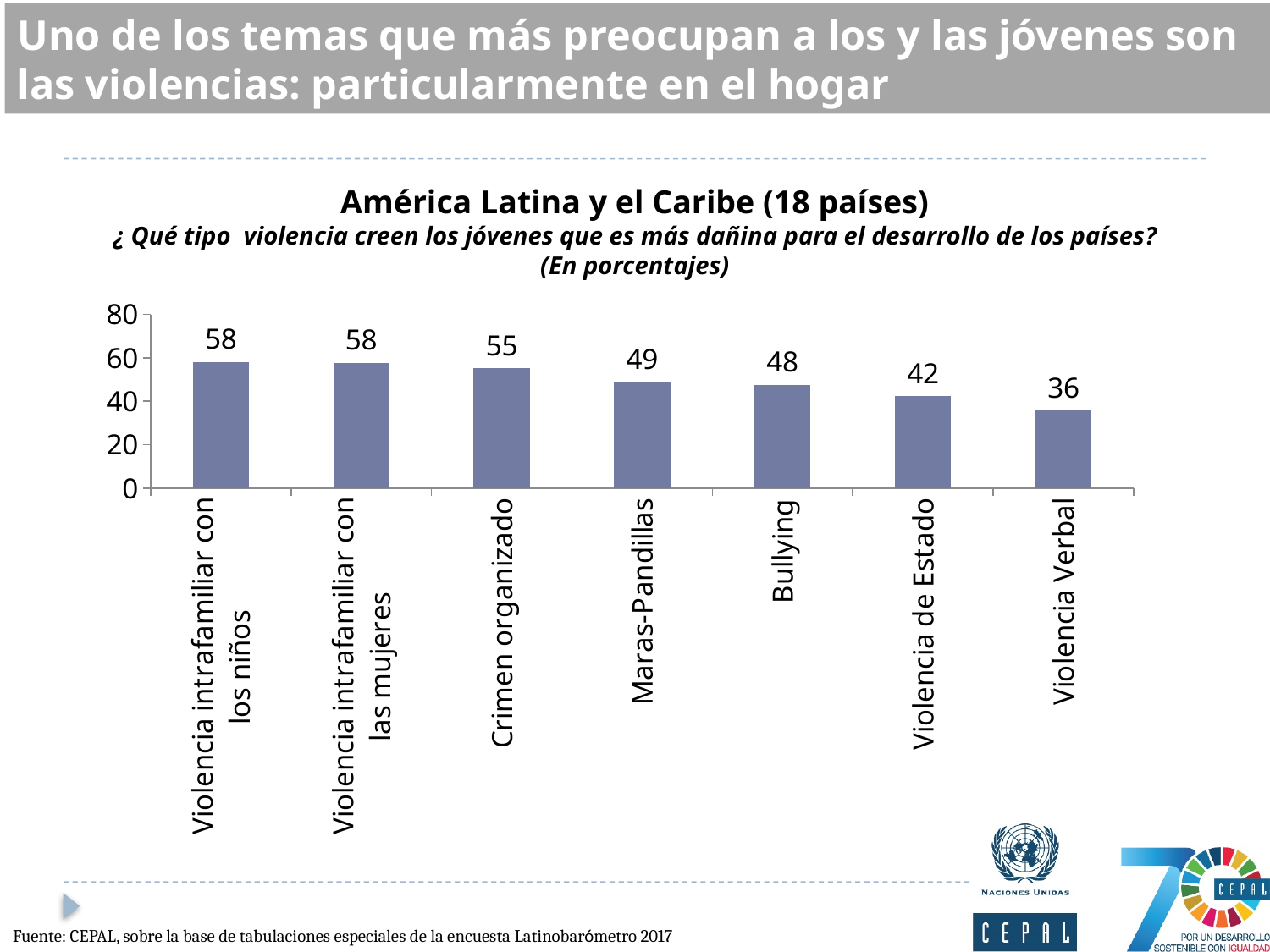
What is the value for Violencia de Estado? 42 What is the value for Maras-Pandillas? 49 How many categories are shown in the chart? 7 What is the value for Crimen organizado? 55 Do the values rise or fall from left to right along the x axis? fall What is the difference between the values for Crimen organizado and Violencia Verbal? 19 Which category has the lowest value? Violencia Verbal What kind of chart is shown on the slide? bar chart Which is larger, the value for Crimen organizado or the value for Bullying? Crimen organizado What is the difference between the values for Violencia intrafamiliar con los niños and Violencia de Estado? 16 What is the value for Bullying? 48 Is the value for Violencia Verbal greater or less than 40? less